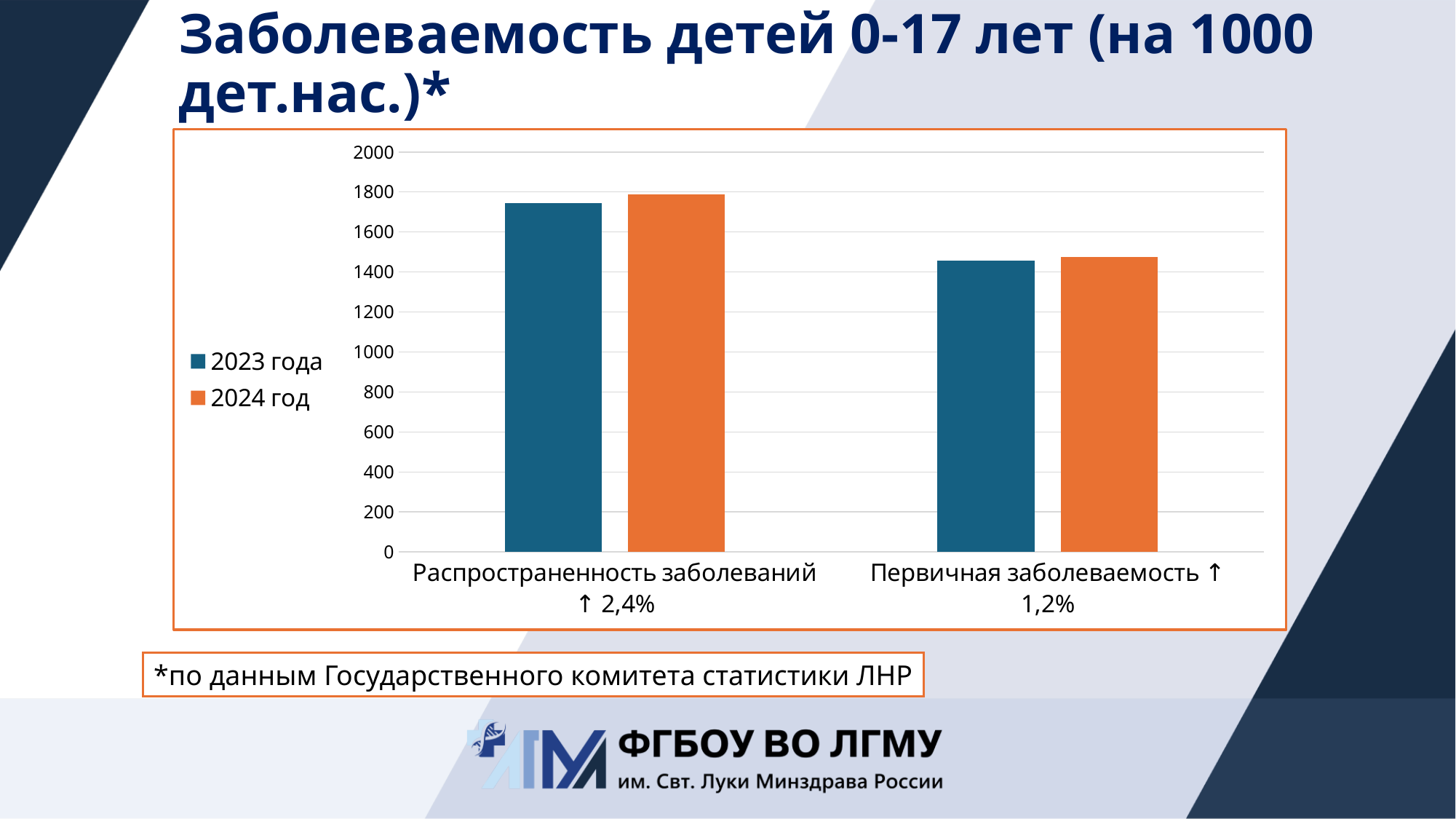
Is the 2023 value for Распространенность заболеваний greater or less than 1600? greater Which category has the lowest 2023 value? Первичная заболеваемость For Распространенность заболеваний, which year has the larger value, 2023 or 2024? 2024 Is the 2024 value for Распространенность заболеваний greater or less than 1600? greater How many categories are shown on the x axis? 2 What is the title of the slide containing the chart? Заболеваемость детей 0-17 лет (на 1000 дет.нас.)* How many series does the legend list? 2 Which category has the higher 2024 value, Распространенность заболеваний or Первичная заболеваемость? Распространенность заболеваний Is the 2023 value for Первичная заболеваемость greater or less than 1400? greater What kind of chart is shown on the slide? bar chart Which series are listed in the legend? 2023 года, 2024 год